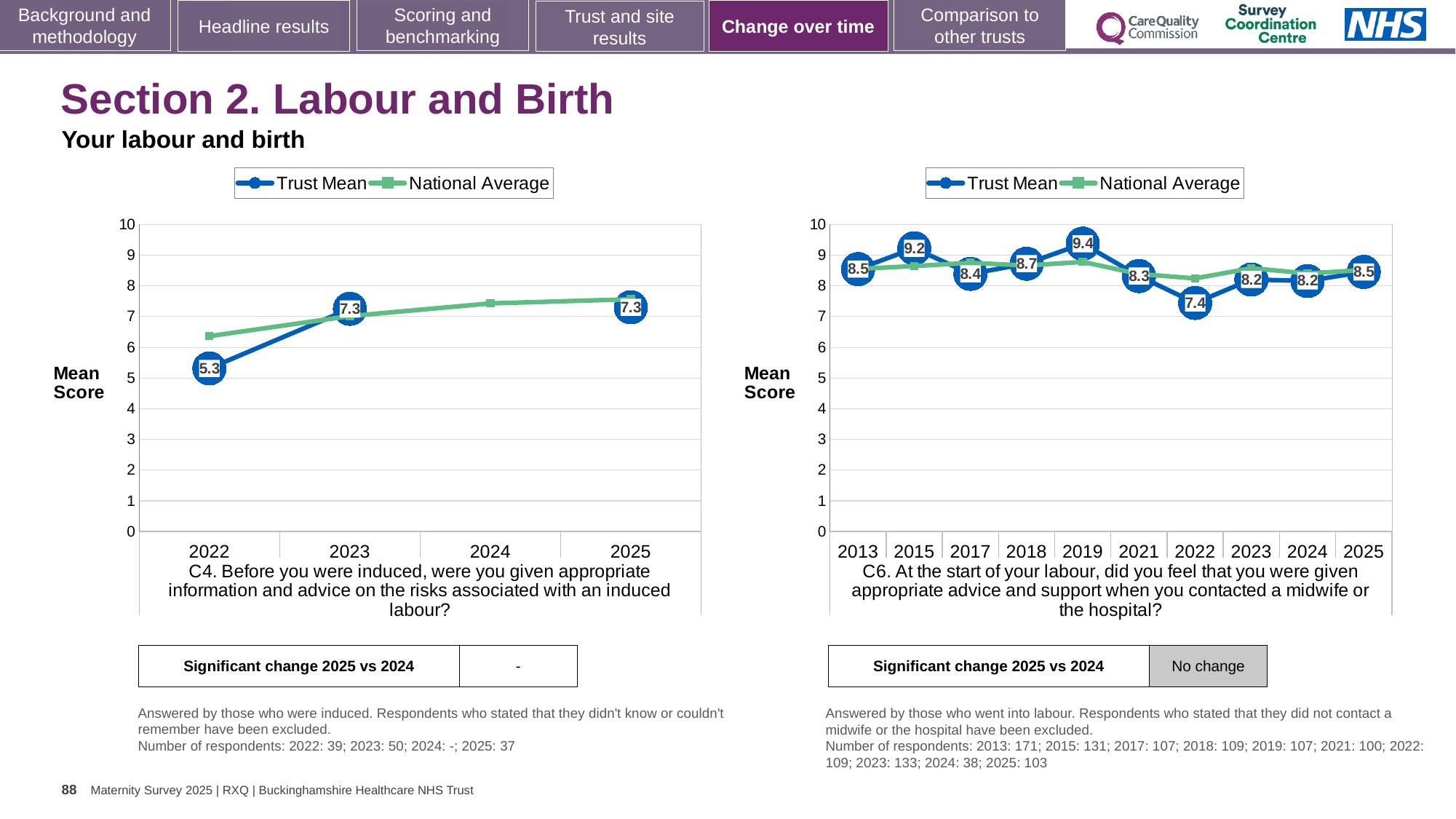
In the right chart (C6), which year has the lowest Trust Mean score? 2022 What type of chart is the right chart (C6)? Line chart In the right chart (C6), how many years are shown on the x axis? 10 In the left chart (C4), is the National Average value for 2022 greater or less than 6? greater In the left chart (C4), what is the Trust Mean score for 2022? 5.3 In the right chart (C6), which year has the highest Trust Mean score? 2019 In the left chart (C4), what is the Trust Mean score for 2025? 7.3 In the right chart (C6), which is larger: the Trust Mean score for 2018 or for 2021? 2018 In the right chart (C6), what is the Trust Mean score for 2019? 9.4 In the left chart (C4), how many series does the legend list? 2 In the left chart (C4), what is the difference between the Trust Mean scores for 2023 and 2022? 2.0 In the right chart (C6), what is the difference between the Trust Mean scores for 2015 and 2022? 1.8